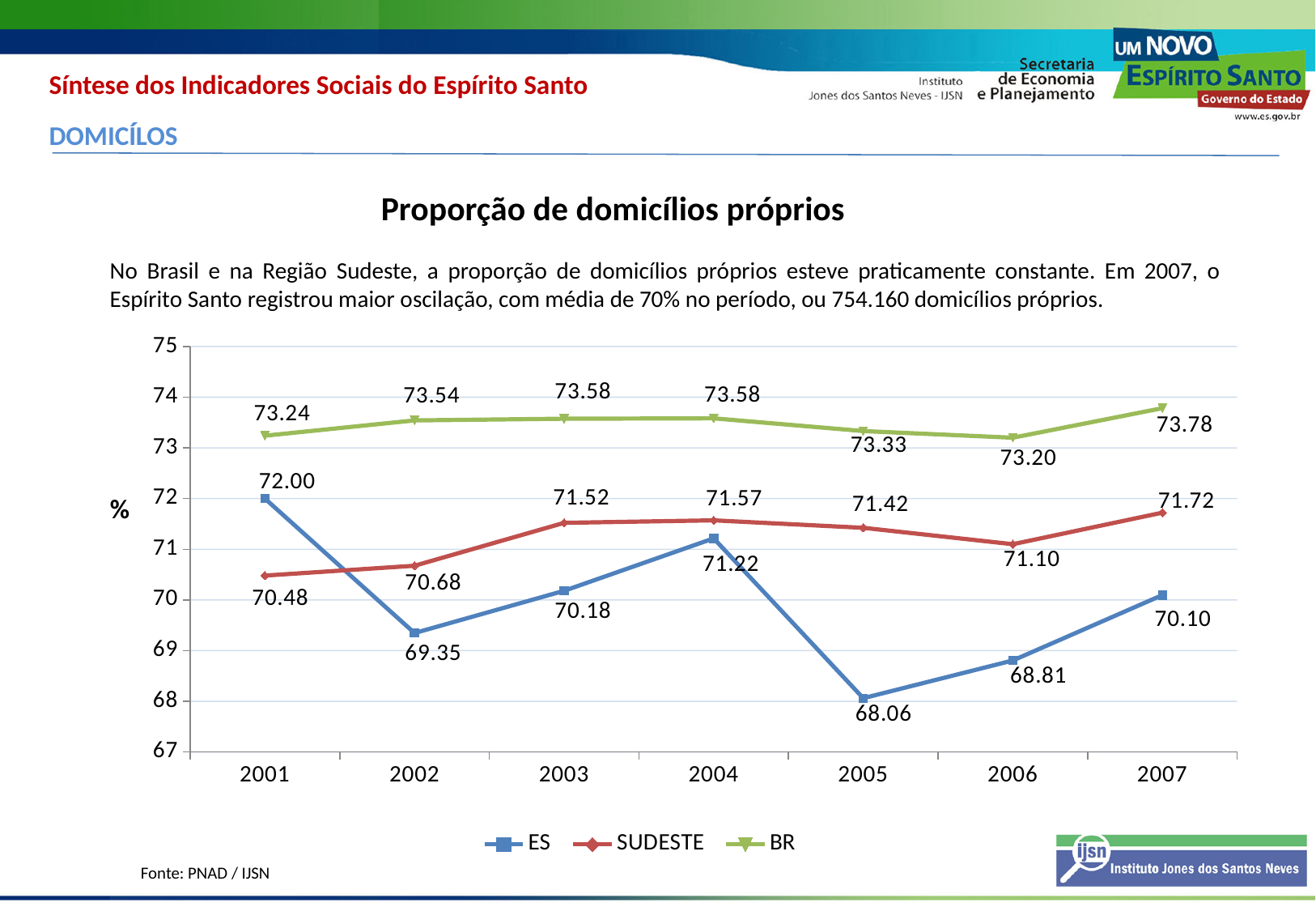
What is the title of the chart? Proporção de domicílios próprios What is the value for SUDESTE in 2003? 71.52 Which is larger in 2004: the ES value or the SUDESTE value? SUDESTE Does the ES series rise or fall from 2005 to 2007? rise How many series does the legend list? 3 What is the value for ES in 2005? 68.06 What type of chart is shown on the slide? line chart How many years are shown on the x axis? 7 What is the value for BR in 2007? 73.78 In which year is the ES series at its lowest? 2005 What is the difference between the ES values in 2001 and 2002? 2.65 In which year is the BR series at its highest? 2007